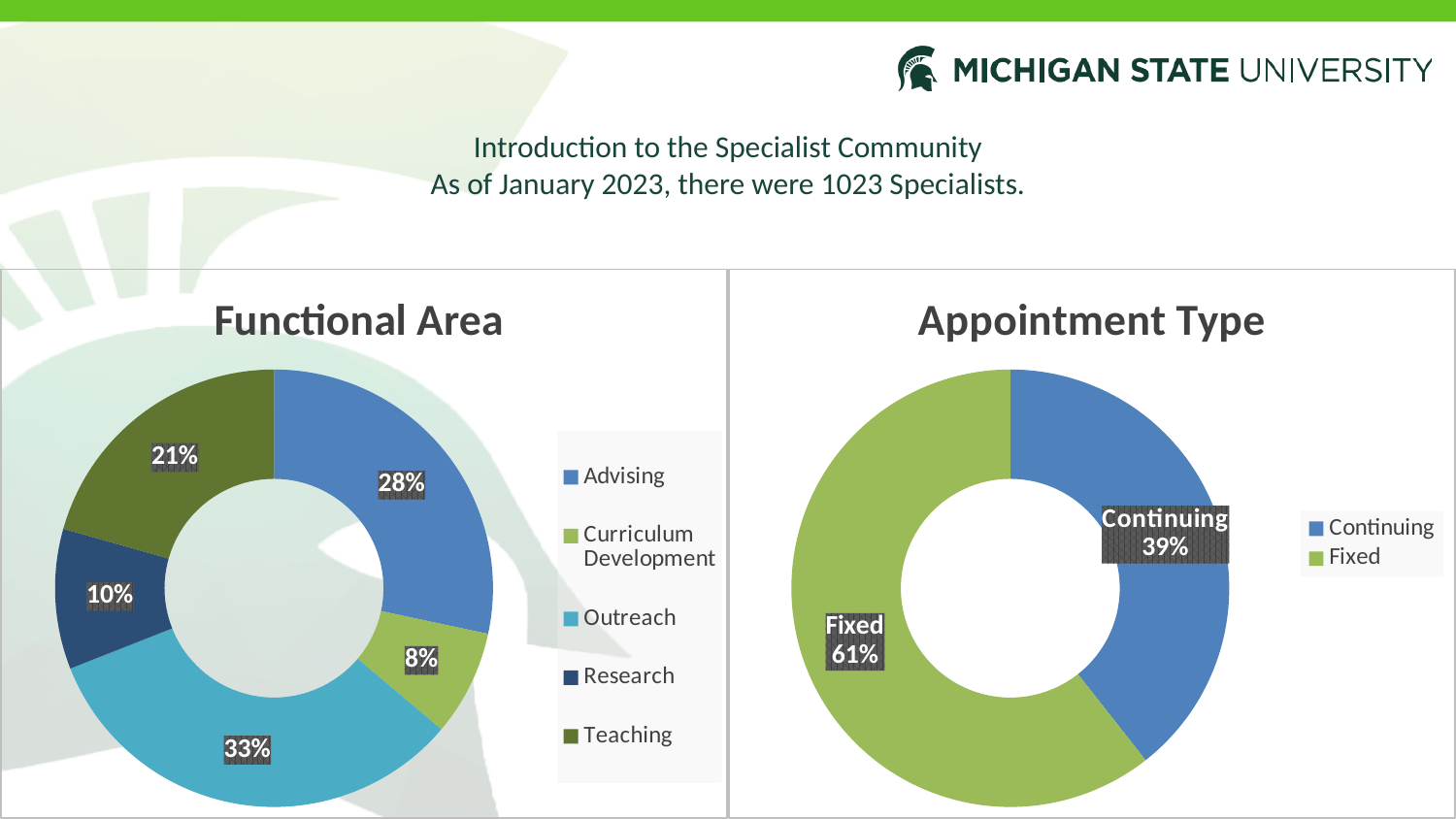
How many categories does the Functional Area chart show? 5 In the Functional Area chart, what percentage is Curriculum Development? 8% In the Functional Area chart, which functional area has the smallest share? Curriculum Development In the Functional Area chart, what percentage is Outreach? 33% What kind of chart is the Appointment Type chart? Doughnut chart In the Functional Area chart, which functional area has the largest share? Outreach In the Functional Area chart, what percentage is Advising? 28% In the Functional Area chart, what is the difference in percentage points between Teaching and Research? 11 In the Appointment Type chart, what percentage of specialists have a Fixed appointment? 61% In the Appointment Type chart, what is the difference in percentage points between Fixed and Continuing? 22 In the Functional Area chart, which is larger, Advising or Teaching? Advising In the Appointment Type chart, what percentage of specialists have a Continuing appointment? 39%